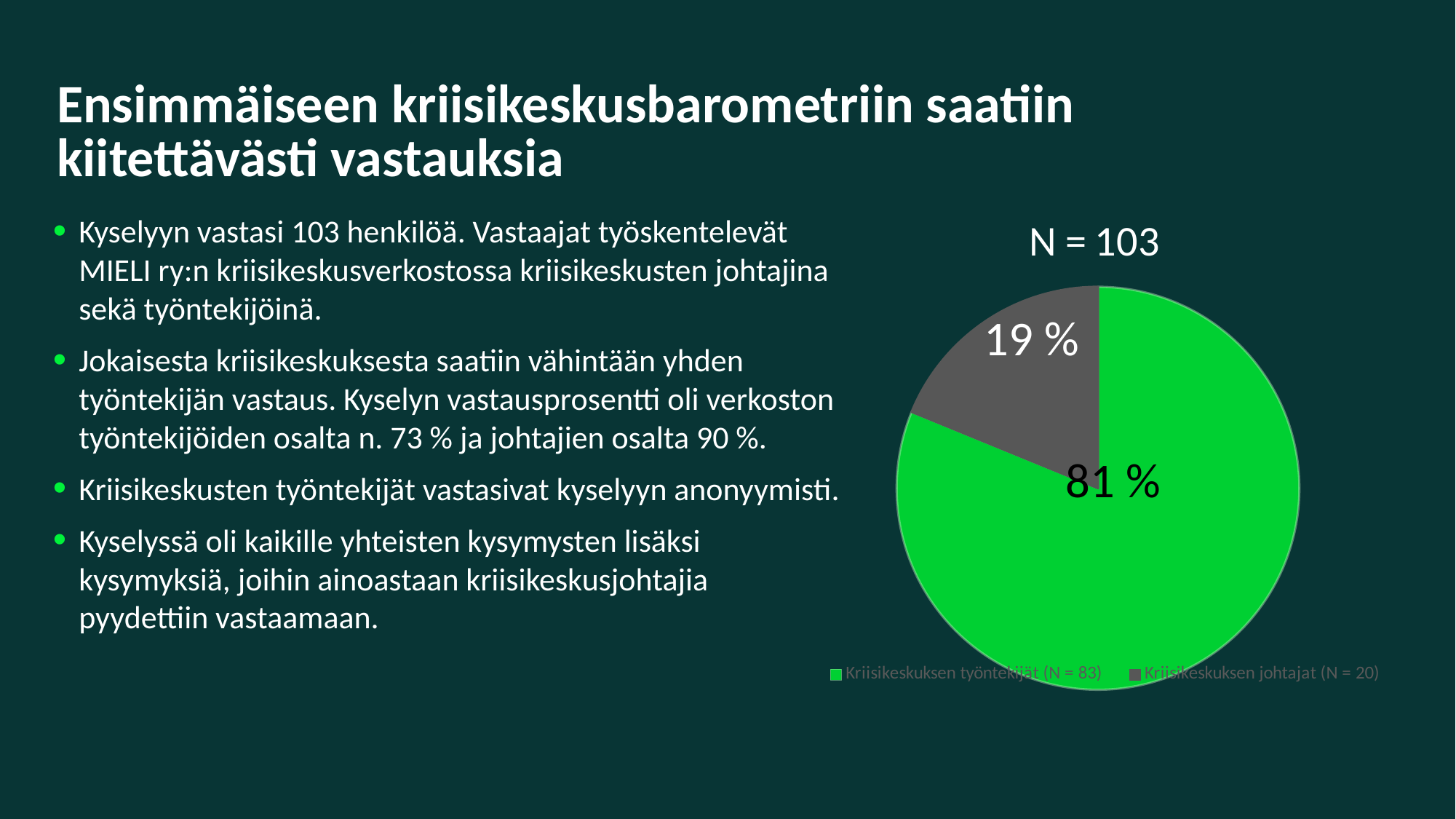
Which is larger: the share for Kriisikeskuksen johtajat or the share for Kriisikeskuksen työntekijät? Kriisikeskuksen työntekijät What share of the pie is Kriisikeskuksen työntekijät (N = 83)? 81 % What kind of chart is shown on the slide? pie chart Which slice of the pie is the largest? Kriisikeskuksen työntekijät (N = 83) What colour is the Kriisikeskuksen johtajat (N = 20) slice? grey What is the total of the two percentage labels shown on the pie chart? 100 % What is the difference in percentage points between the Kriisikeskuksen työntekijät slice and the Kriisikeskuksen johtajat slice? 62 % How many entries does the chart legend list? 2 What is the title of the chart? N = 103 How many slices does the pie chart have? 2 Which slice of the pie is the smallest? Kriisikeskuksen johtajat (N = 20) What share of the pie is Kriisikeskuksen johtajat (N = 20)? 19 %